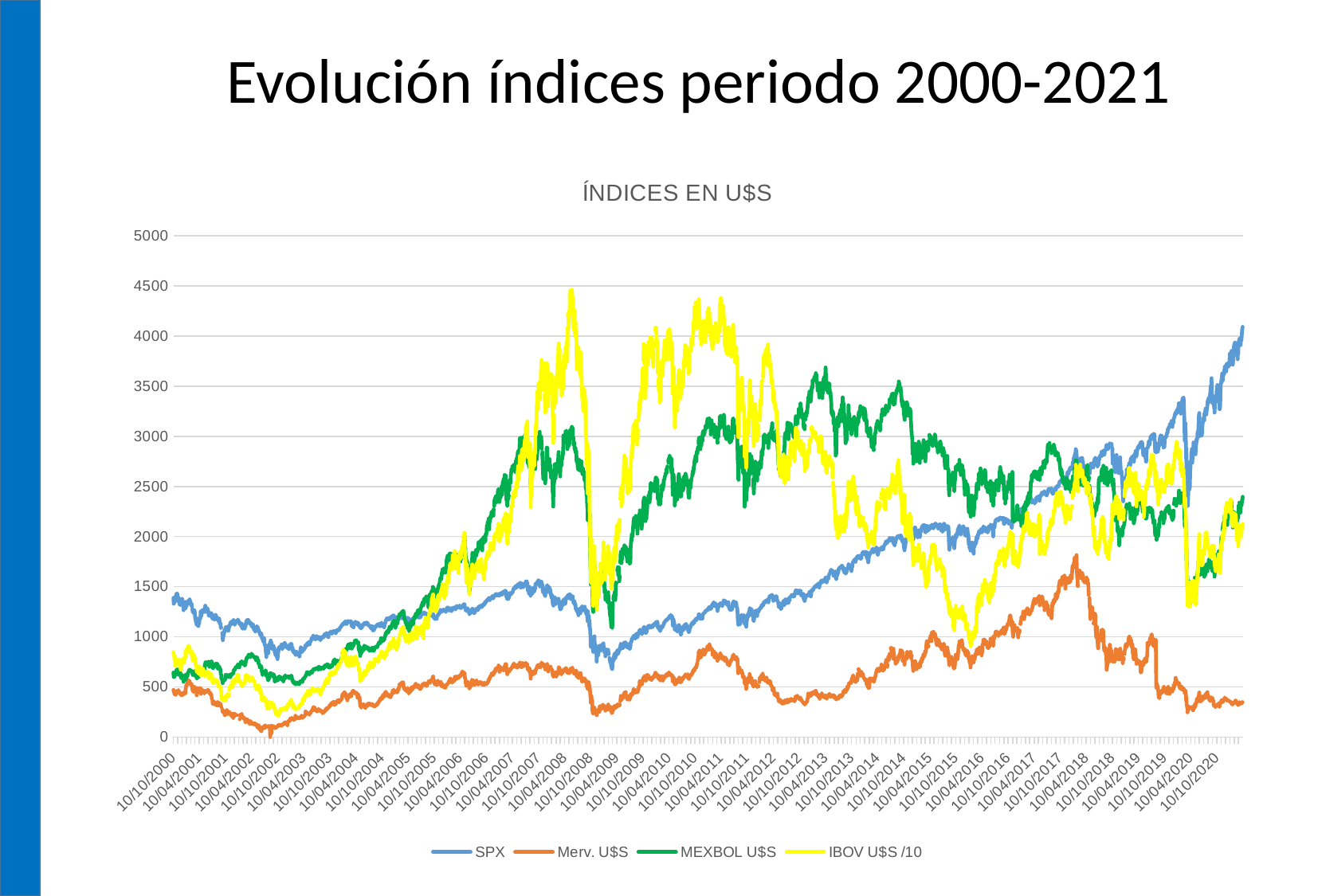
Around 10/10/2007, which is larger: IBOV U$S /10 or SPX? IBOV U$S /10 Which series is drawn in yellow according to the legend? IBOV U$S /10 What is the title printed above the chart's plot area? ÍNDICES EN U$S Does the SPX series rise or fall overall from 2000 to 2021? rise Which series is highest at the right end of the chart (late 2020)? SPX Which series reaches the highest value anywhere on the chart? IBOV U$S /10 What kind of chart is shown on the slide? line chart Which series has the lowest value at the right end of the chart (late 2020)? Merv. U$S Is the peak value of IBOV U$S /10 around 2008 greater or less than 4000? greater Is the value of Merv. U$S at the right end of the chart greater or less than 500? less How many series does the legend list? 4 Is the value of SPX at the right end of the chart greater or less than 3500? greater